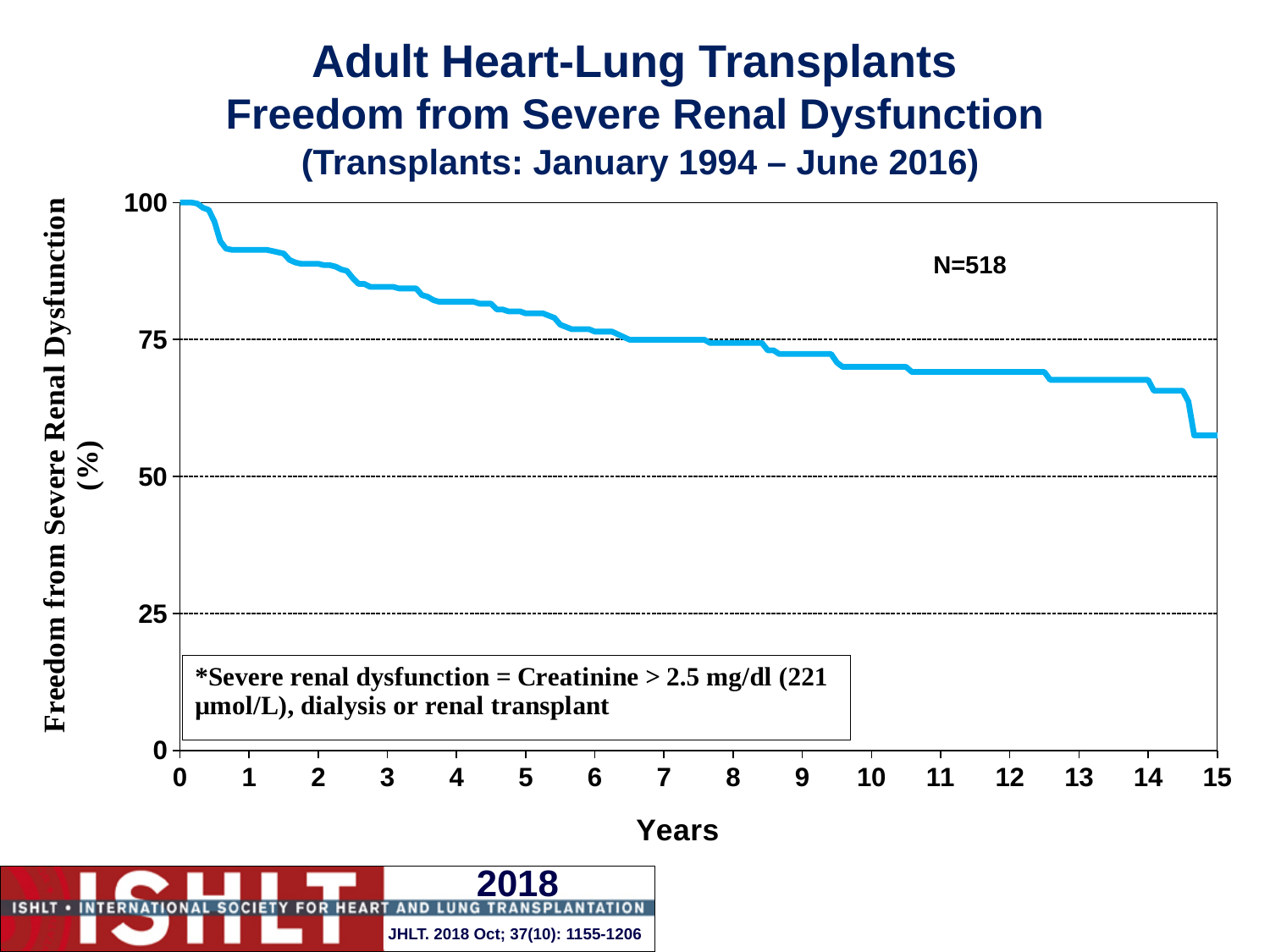
How many lines (series) are plotted on the chart? 1 Is the value for freedom from severe renal dysfunction at year 5 greater or less than 75? greater Is the value for freedom from severe renal dysfunction at year 1 greater or less than 75? greater Which is larger, the value at year 2 or the value at year 12? year 2 Is the value for freedom from severe renal dysfunction at year 15 greater or less than 50? greater What kind of chart is shown on the slide? line chart What is the number of transplants (N) shown on the chart? N=518 What is the value of freedom from severe renal dysfunction at year 0? 100 What is the label of the x axis? Years Does freedom from severe renal dysfunction rise or fall as years since transplant increase? fall